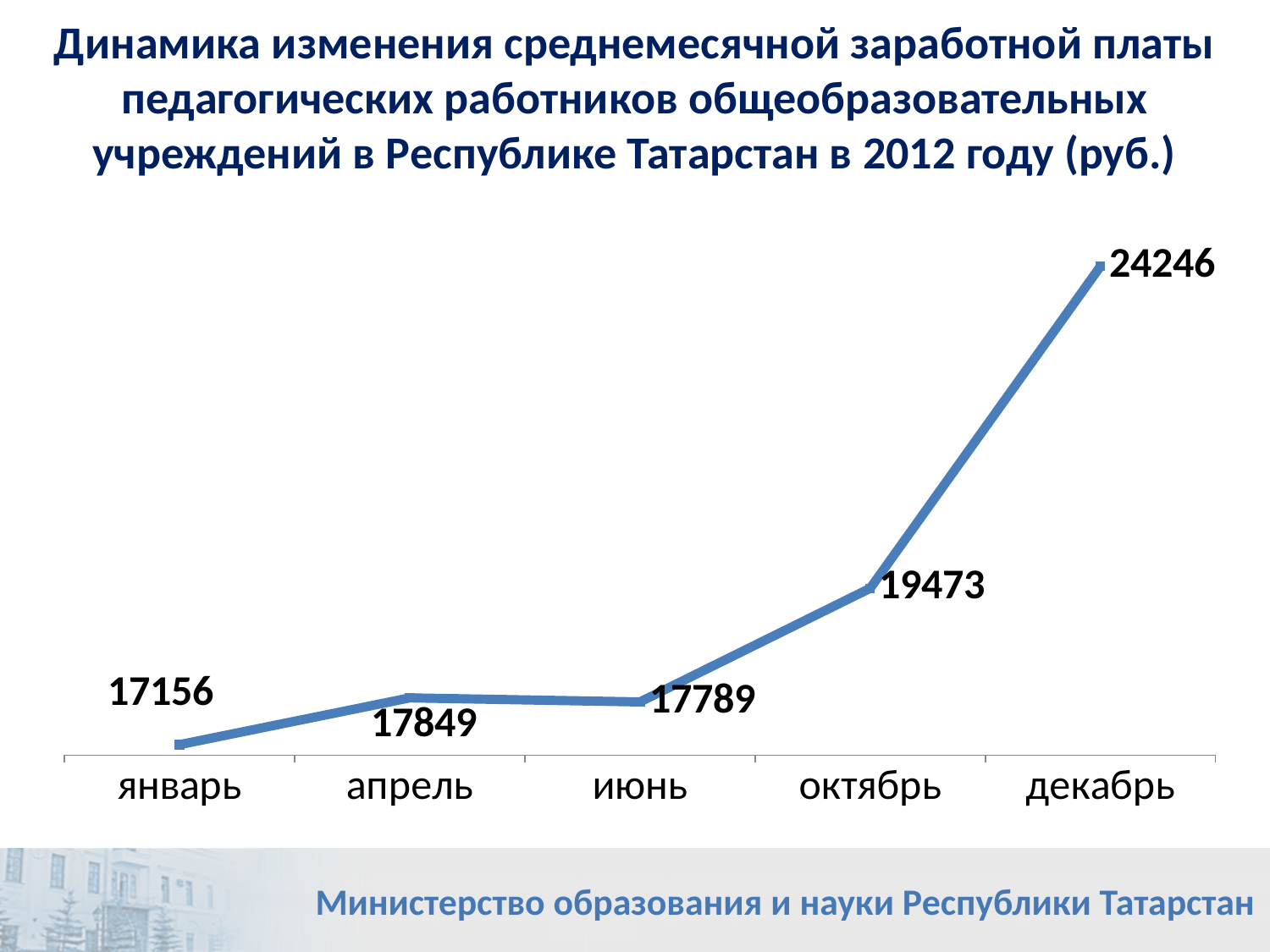
What kind of chart is shown on the slide? line chart How many months are plotted on the x axis? 5 Which is larger, the value for октябрь or the value for январь? октябрь What is the difference between the values for октябрь and июнь? 1684 What value is plotted for июнь? 17789 What is the difference between the values for декабрь and январь? 7090 What is the average monthly salary value shown for январь? 17156 What value is plotted for апрель? 17849 Which month has the lowest value on the chart? январь What value is plotted for октябрь? 19473 Which month has the highest value on the chart? декабрь What value is plotted for декабрь? 24246